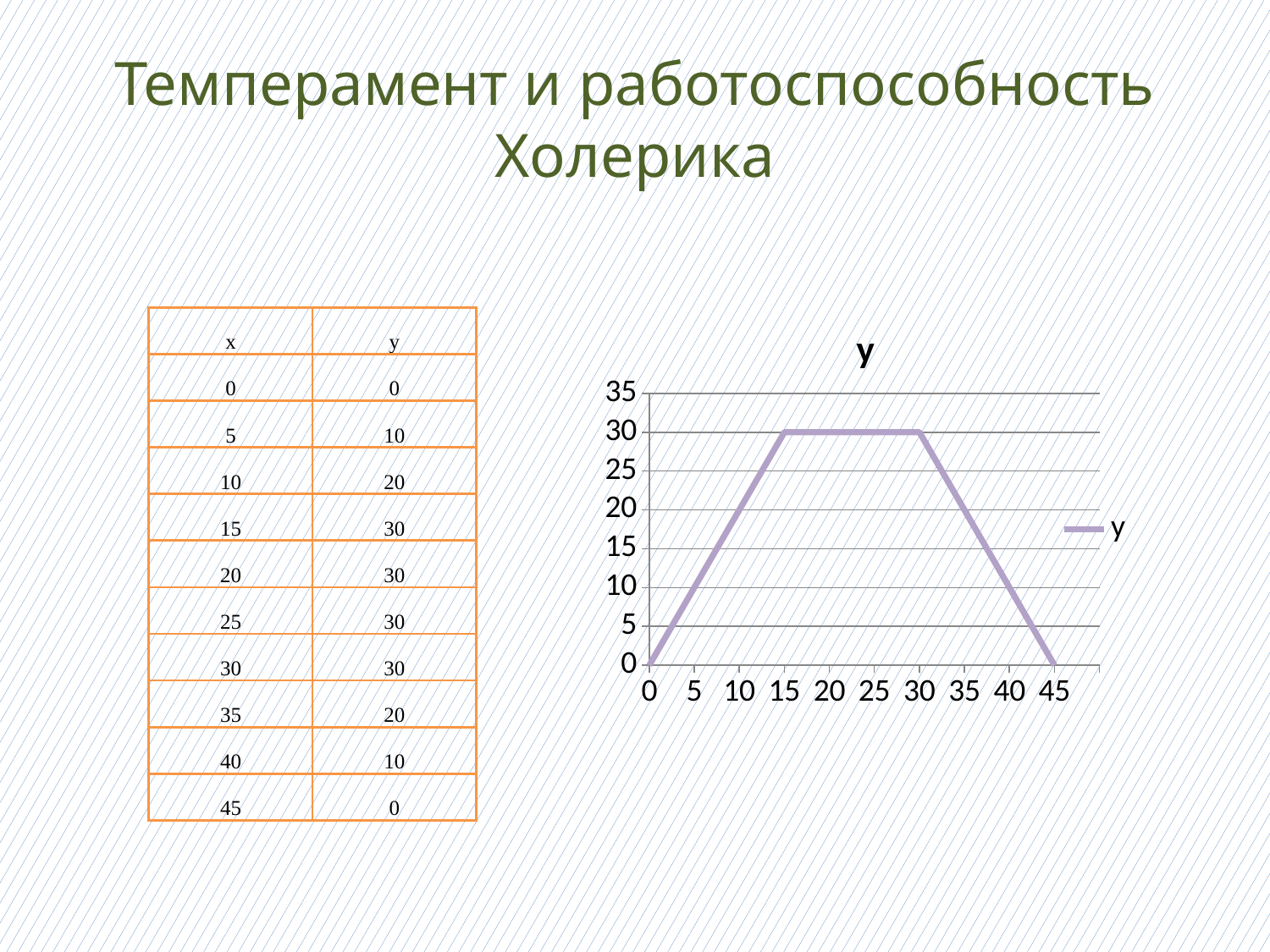
What kind of chart is shown on the slide? line chart Which is larger, the value of y at x = 20 or at x = 35? x = 20 What is the value of y at x = 15? 30 How many data points are plotted on the line? 10 What is the highest value of y reached on the chart? 30 Does the value of y rise or fall between x = 30 and x = 45? fall What is the lowest value of y on the chart? 0 What is the value of y at x = 45? 0 What is the value of y at x = 40? 10 What is the difference between the value of y at x = 10 and at x = 5? 10 What is the title of the chart? y How many series does the chart legend list? 1